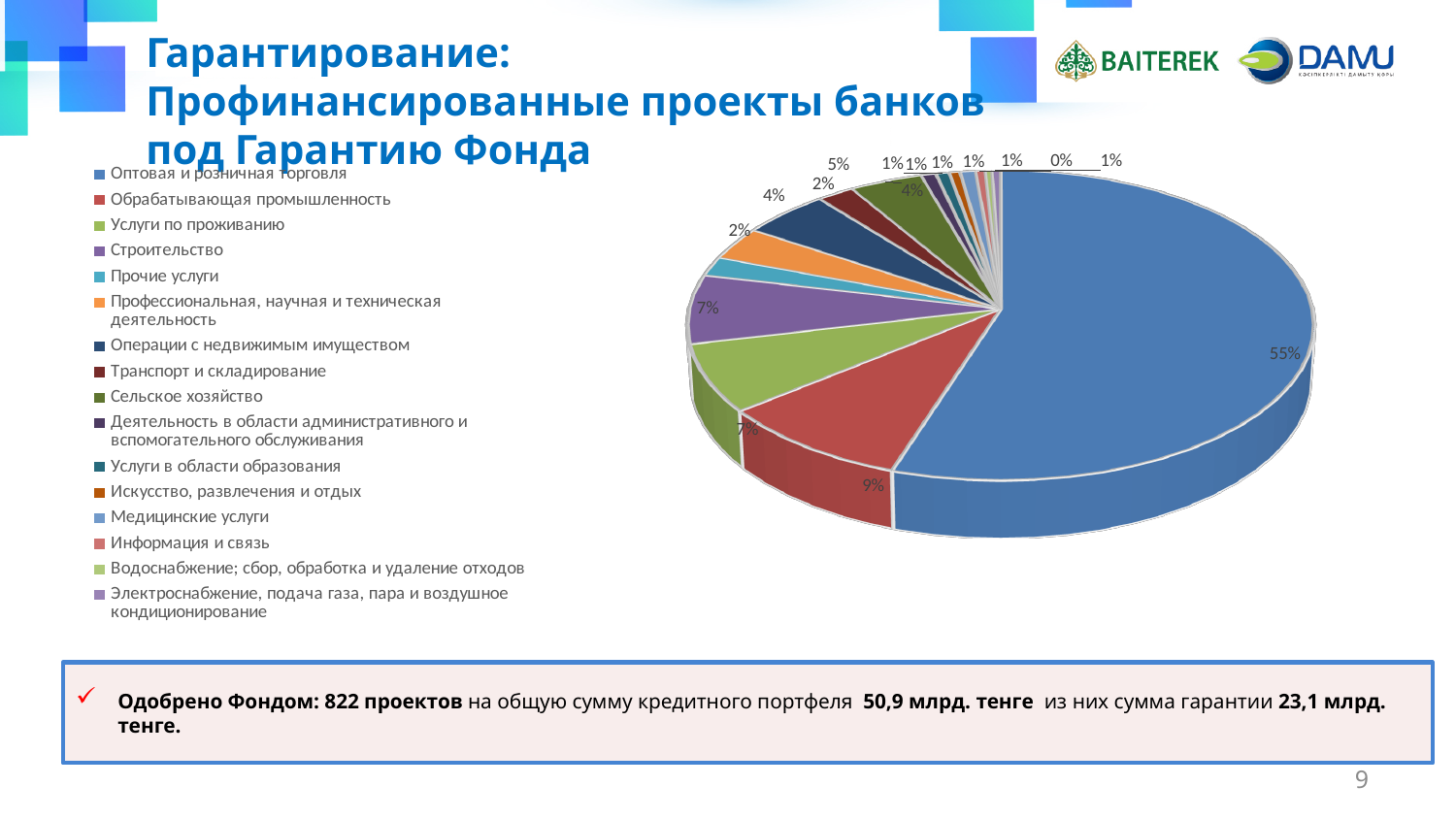
Which category has the largest share of the pie? Оптовая и розничная торговля What share of the pie does Сельское хозяйство have? 4% What is the difference in percentage points between Оптовая и розничная торговля and Обрабатывающая промышленность? 46 percentage points Is the share for Оптовая и розничная торговля greater or less than 50%? greater What share of the pie does Оптовая и розничная торговля have? 55% What kind of chart is shown on the slide? Pie chart What share of the pie does Услуги по проживанию have? 7% Which is larger, the share for Обрабатывающая промышленность or the share for Строительство? Обрабатывающая промышленность How many categories does the legend list? 16 What colour is the slice for Обрабатывающая промышленность? Red